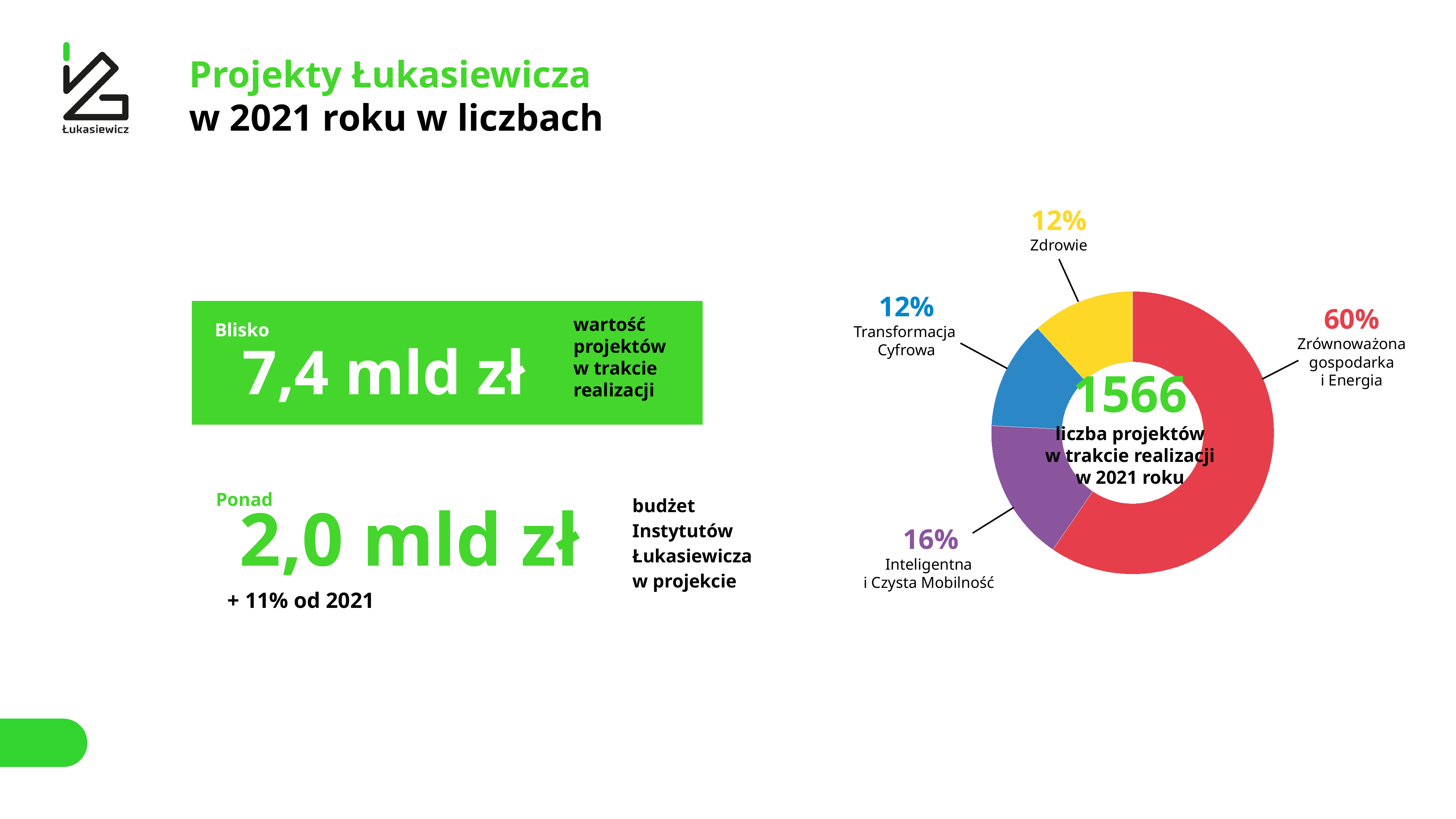
What share of the donut chart does Zrównoważona gospodarka i Energia represent? 60% What kind of chart is shown on the right side of the slide? Donut (pie) chart What percentage is shown for Inteligentna i Czysta Mobilność in the donut chart? 16% What percentage is shown for Transformacja Cyfrowa in the donut chart? 12% Which category has the largest share in the donut chart? Zrównoważona gospodarka i Energia What colour is the slice for Zdrowie in the donut chart? Yellow What percentage is shown for Zdrowie in the donut chart? 12% What number is displayed in the centre of the donut chart? 1566 What is the difference in percentage points between Zrównoważona gospodarka i Energia and Inteligentna i Czysta Mobilność? 44 What is the difference in percentage points between Inteligentna i Czysta Mobilność and Zdrowie? 4 How many categories are shown in the donut chart? 4 Which has a larger share: Inteligentna i Czysta Mobilność or Transformacja Cyfrowa? Inteligentna i Czysta Mobilność